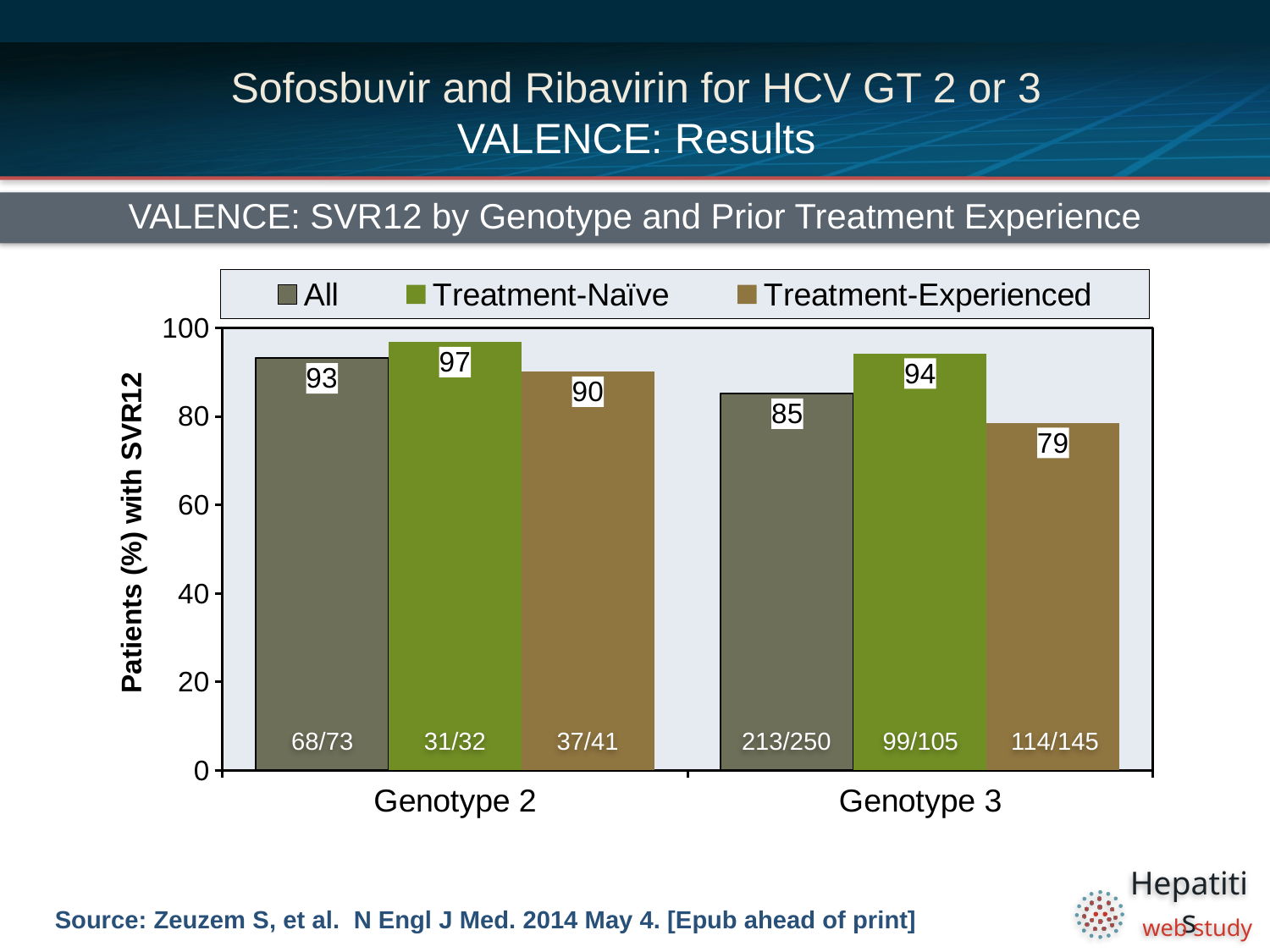
What is the SVR12 rate for the Treatment-Experienced group in Genotype 3? 79 Which is larger, the All SVR12 rate for Genotype 2 or for Genotype 3? Genotype 2 Which bar has the lowest SVR12 rate on the chart? Treatment-Experienced, Genotype 3 How many series does the legend list? 3 How many genotype categories are shown on the x axis? 2 What kind of chart is shown on the slide? Bar chart What is the SVR12 rate for the All group in Genotype 3? 85 What fraction of patients is shown for the Treatment-Experienced bar in Genotype 2? 37/41 What is the SVR12 rate for the Treatment-Naïve group in Genotype 2? 97 What is the difference in SVR12 rate between the Treatment-Naïve and Treatment-Experienced groups in Genotype 3? 15 What is the label of the y axis? Patients (%) with SVR12 Which bar has the highest SVR12 rate on the chart? Treatment-Naïve, Genotype 2